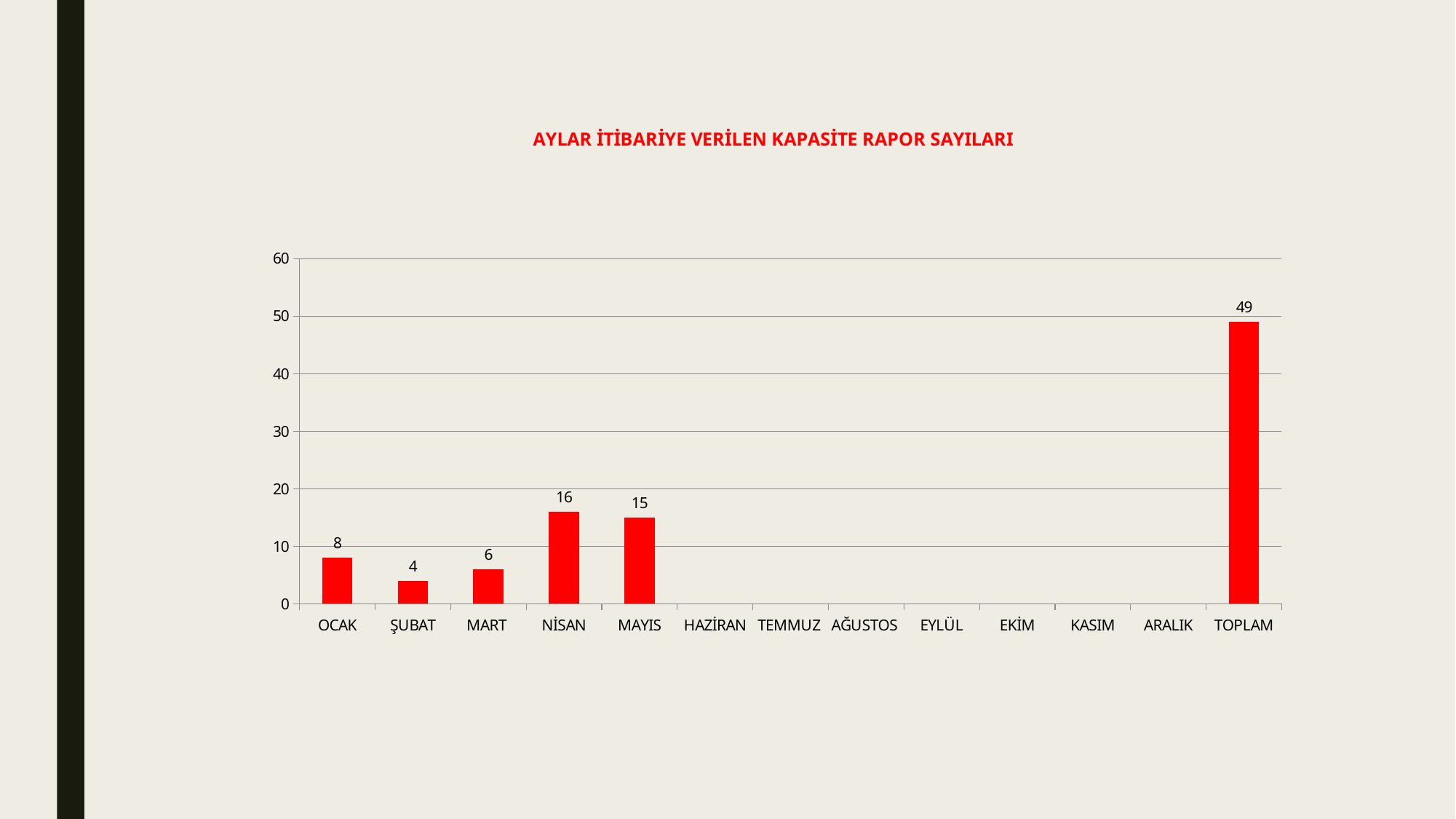
Which month among OCAK to MAYIS has the lowest value? ŞUBAT What is the title of the chart? AYLAR İTİBARİYE VERİLEN KAPASİTE RAPOR SAYILARI What is the value for NİSAN? 16 What is the value for OCAK? 8 Is the value for TOPLAM greater or less than 40? greater How many categories are shown on the x axis? 13 What is the value for TOPLAM? 49 What kind of chart is shown? bar chart Which category has the highest bar? TOPLAM What is the difference between the values for OCAK and ŞUBAT? 4 Which is larger, the value for MART or the value for OCAK? OCAK What is the difference between the values for NİSAN and MAYIS? 1